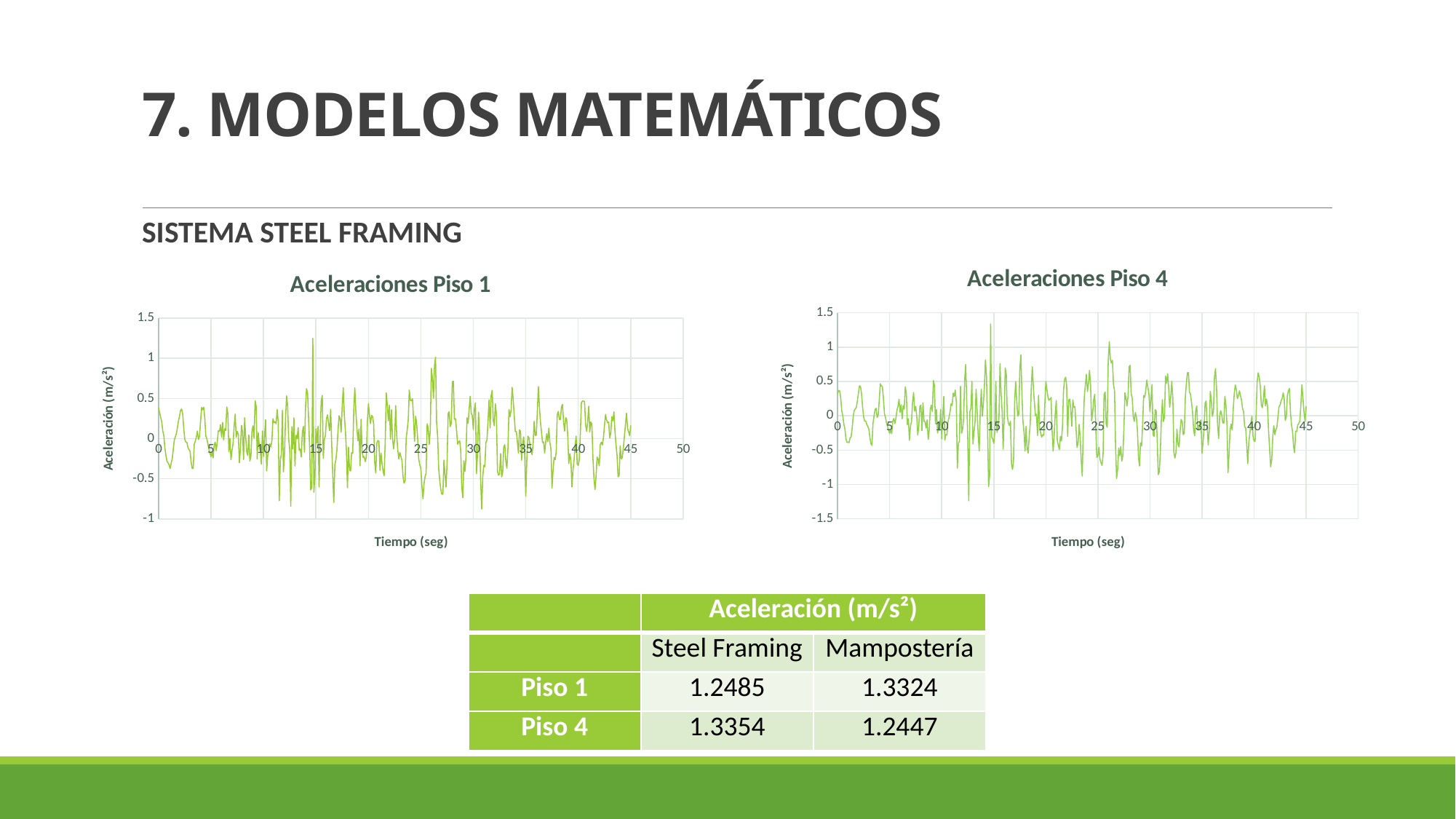
What kind of chart is "Aceleraciones Piso 4"? line chart In the "Aceleraciones Piso 1" chart, is the highest peak of the line greater or less than 1? greater What kind of chart is "Aceleraciones Piso 1"? line chart According to the table below the charts, which is larger for Piso 1: the Steel Framing or the Mampostería acceleration? Mampostería What is the y-axis title of the "Aceleraciones Piso 4" chart? Aceleración (m/s²) In the "Aceleraciones Piso 1" chart, is the lowest point of the line greater or less than -0.5? less In the "Aceleraciones Piso 4" chart, is the lowest point of the line greater or less than -1? less What is the lowest tick value shown on the y-axis of the "Aceleraciones Piso 1" chart? -1 What is the lowest tick value shown on the y-axis of the "Aceleraciones Piso 4" chart? -1.5 According to the table below the charts, what is the Steel Framing acceleration for Piso 4? 1.3354 What is the x-axis title of the "Aceleraciones Piso 1" chart? Tiempo (seg)